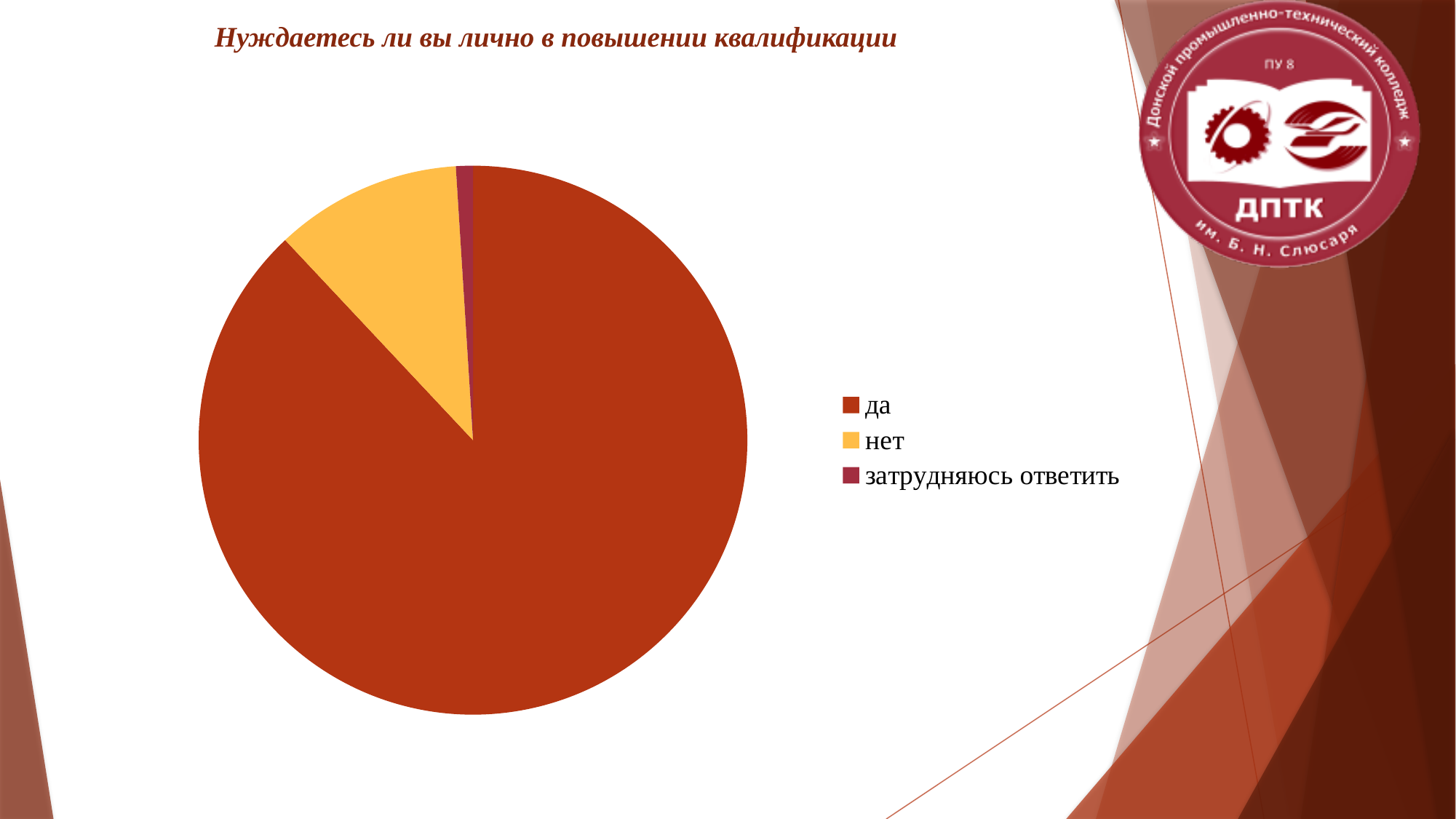
What kind of chart is shown on the slide? pie chart Which slice is larger, "нет" or "затрудняюсь ответить"? нет What colour is the slice for "нет"? yellow How many categories does the pie chart have? 3 Which category has the smallest slice of the pie? затрудняюсь ответить What is the title of the chart? Нуждаетесь ли вы лично в повышении квалификации How many entries does the legend list? 3 Which category has the largest slice of the pie? да Which slice is larger, "да" or "нет"? да